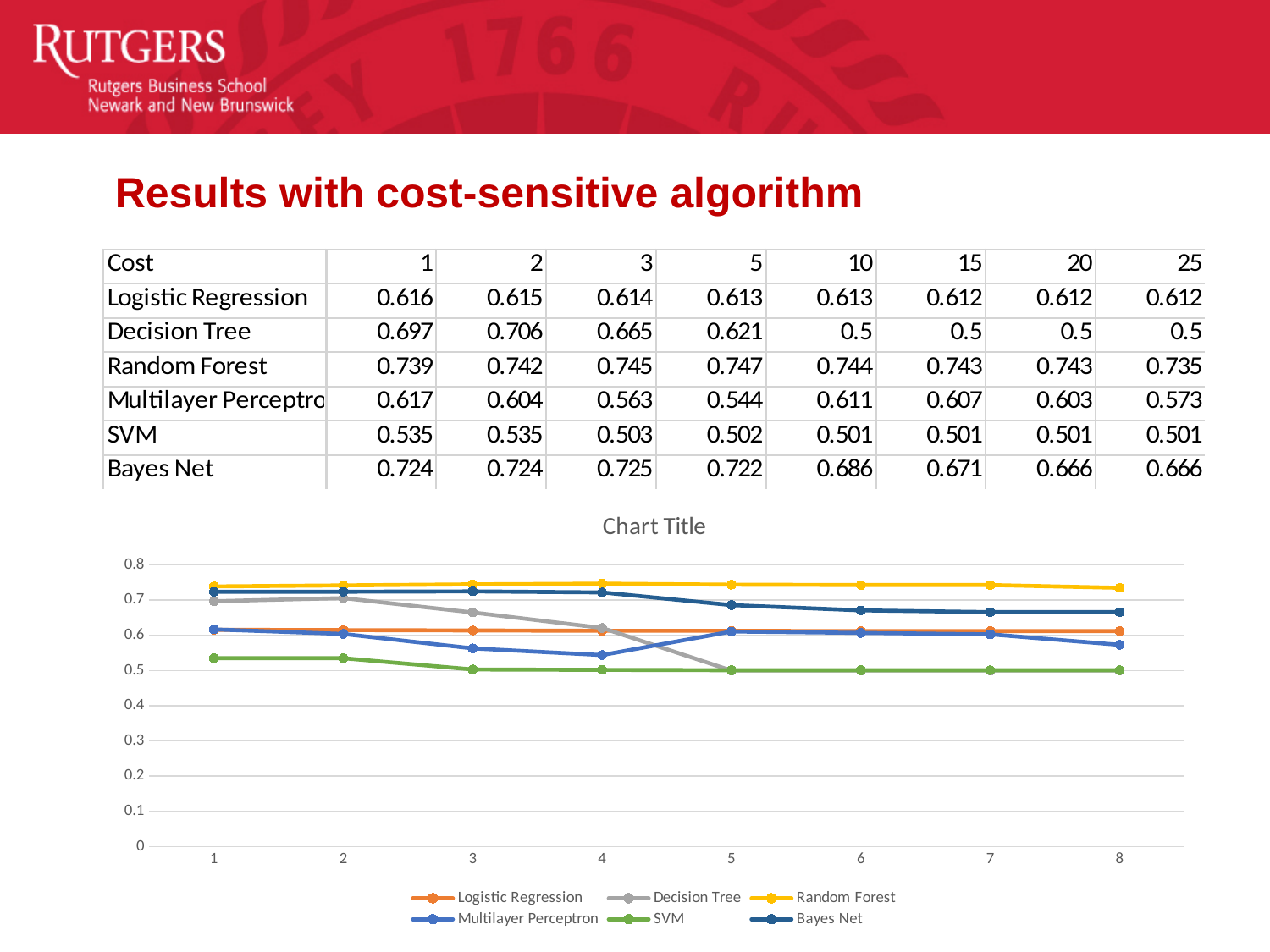
How many series does the chart legend list? 6 Does the Decision Tree line rise or fall from x = 3 to x = 5? fall Is the value of the SVM line at x = 8 greater or less than 0.6? less According to the table, what is the Random Forest value at cost 5? 0.747 Which series has the lowest value at x = 1 on the chart? SVM Which series has the highest values across the chart? Random Forest Is the value of the Random Forest line at x = 1 greater or less than 0.7? greater How many points are there along the x axis of the chart? 8 What is the title shown above the chart? Chart Title What kind of chart is shown on the slide? line chart At x = 8, which line is higher: Bayes Net or Multilayer Perceptron? Bayes Net According to the table, what is the difference between the Bayes Net value at cost 1 and at cost 25? 0.058